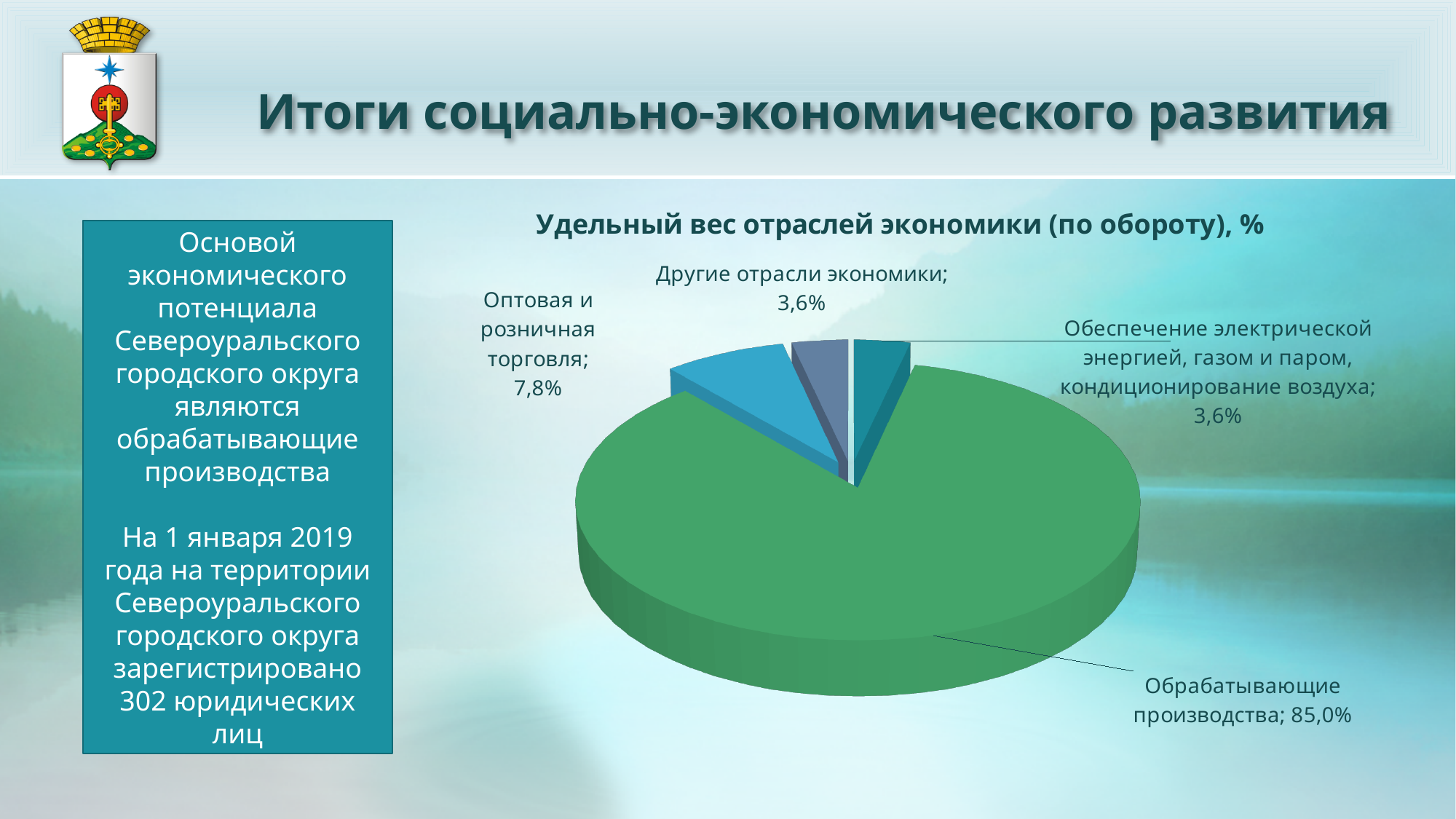
What kind of chart is shown on the slide? Pie chart Which category has the largest slice of the pie? Обрабатывающие производства What share of the pie does Обрабатывающие производства have? 85,0% What is the combined share of Другие отрасли экономики and Обеспечение электрической энергией, газом и паром, кондиционирование воздуха? 7,2% What is the difference between the shares of Обрабатывающие производства and Оптовая и розничная торговля? 77,2% Which is larger: the share of Оптовая и розничная торговля or the share of Другие отрасли экономики? Оптовая и розничная торговля What is the value shown for Другие отрасли экономики? 3,6% What is the title of the chart? Удельный вес отраслей экономики (по обороту), % What colour is the slice for Обрабатывающие производства? Green What is the value shown for Обеспечение электрической энергией, газом и паром, кондиционирование воздуха? 3,6% How many slices does the pie chart have? 4 What is the value shown for Оптовая и розничная торговля? 7,8%